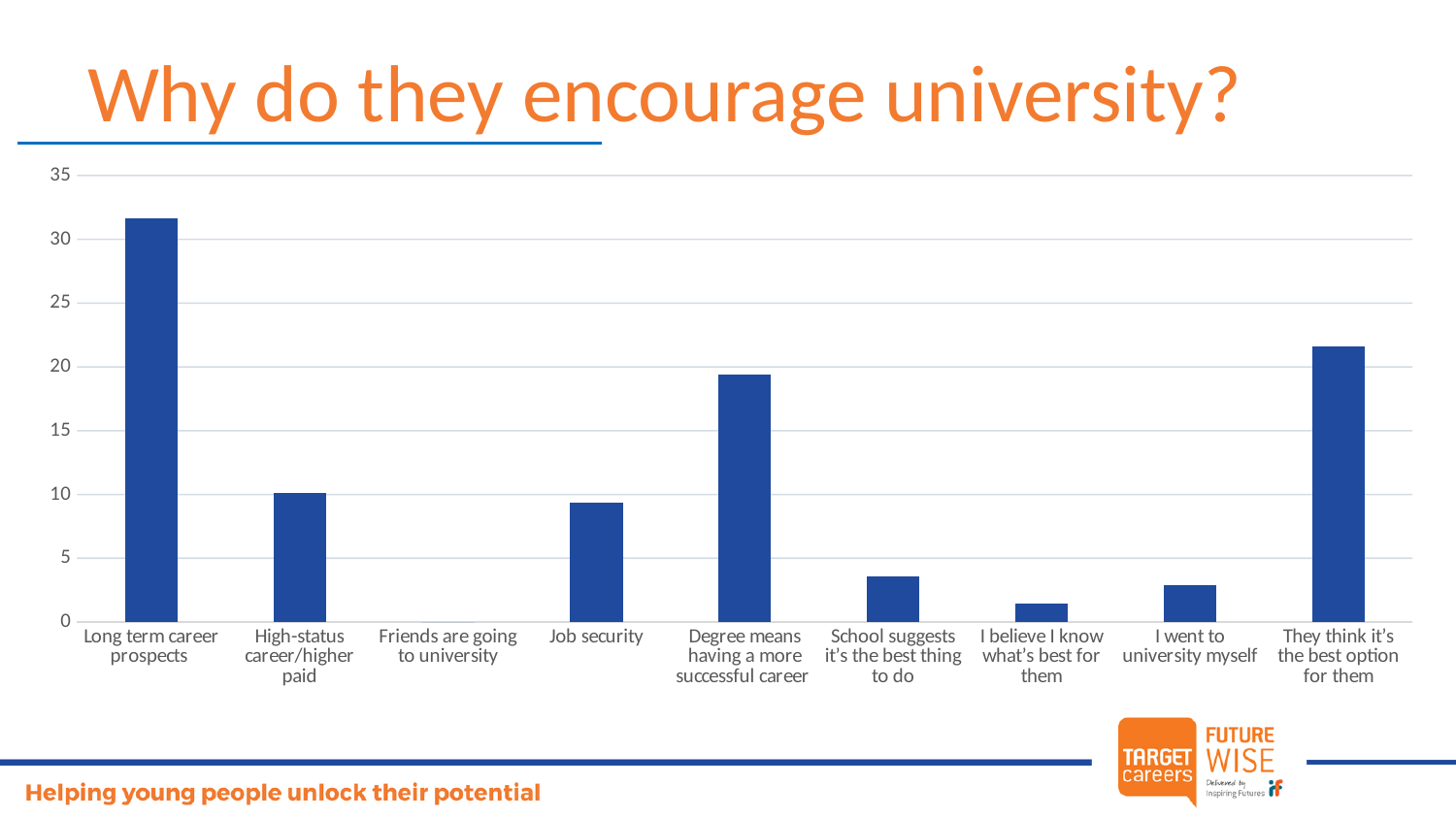
Which category has the highest value? Long term career prospects Is the value for Long term career prospects greater or less than 30? greater Is the value for They think it's the best option for them greater or less than 20? greater Is the value for School suggests it's the best thing to do greater or less than 5? less Which is larger: the value for Long term career prospects or the value for They think it's the best option for them? Long term career prospects What kind of chart is shown on the slide? bar chart Which category has the lowest value? Friends are going to university How many categories are shown on the x axis of the chart? 9 Which is larger: the value for Degree means having a more successful career or the value for They think it's the best option for them? They think it's the best option for them What is the title of the slide? Why do they encourage university?